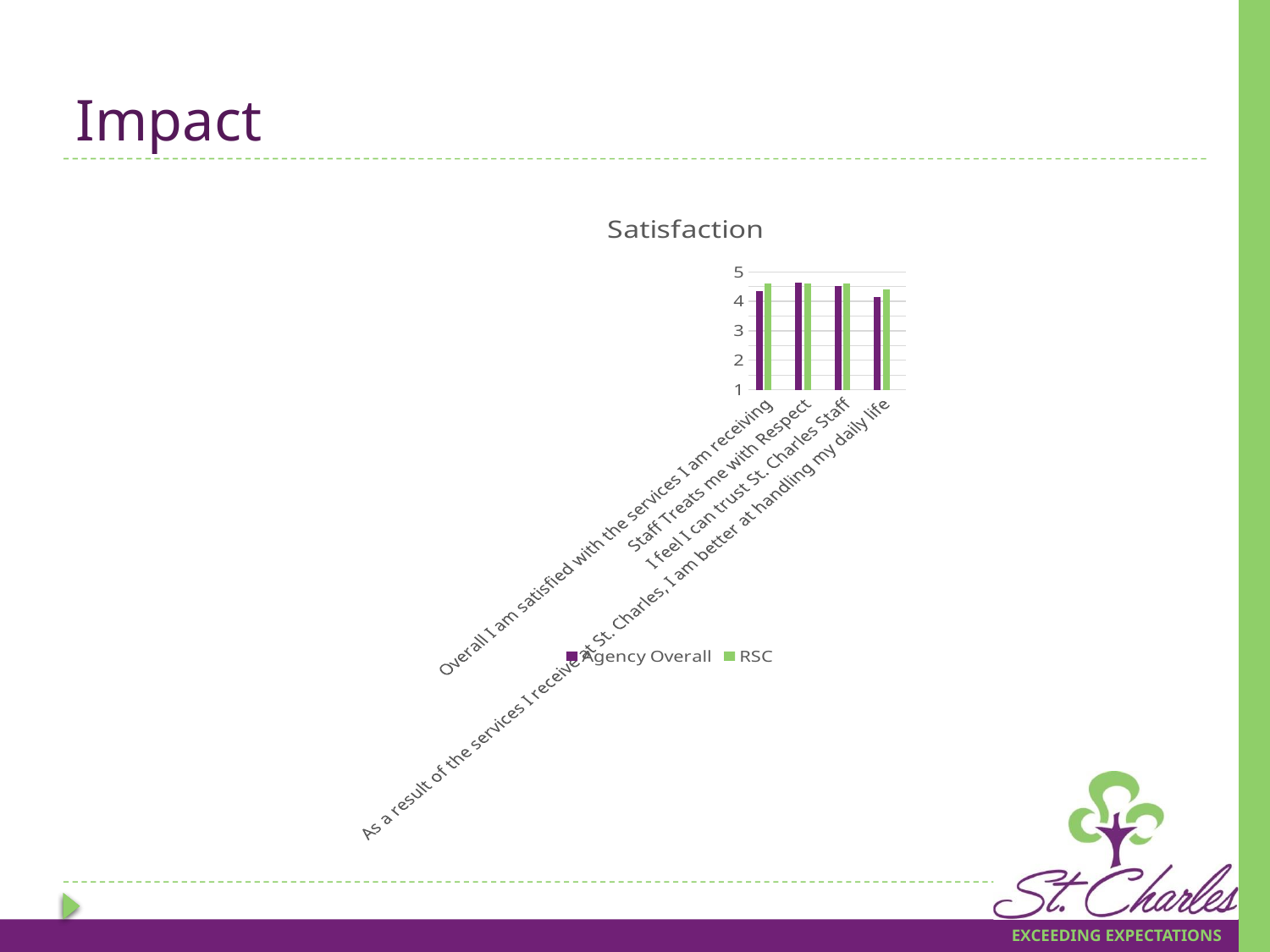
How many categories are shown on the x axis? 4 What are the two series named in the legend? Agency Overall and RSC Which category has the lowest Agency Overall value? As a result of the services I receive at St. Charles, I am better at handling my daily life Is the RSC value for 'I feel I can trust St. Charles Staff' greater or less than 5? less Is the Agency Overall value for 'Staff Treats me with Respect' greater or less than 4? greater For 'Overall I am satisfied with the services I am receiving', which series has the larger value, Agency Overall or RSC? RSC For 'As a result of the services I receive at St. Charles, I am better at handling my daily life', which series has the larger value, Agency Overall or RSC? RSC What is the title of the chart? Satisfaction How many series does the legend list? 2 Is the RSC value for 'Overall I am satisfied with the services I am receiving' greater or less than 4? greater What kind of chart is shown on the slide? bar chart